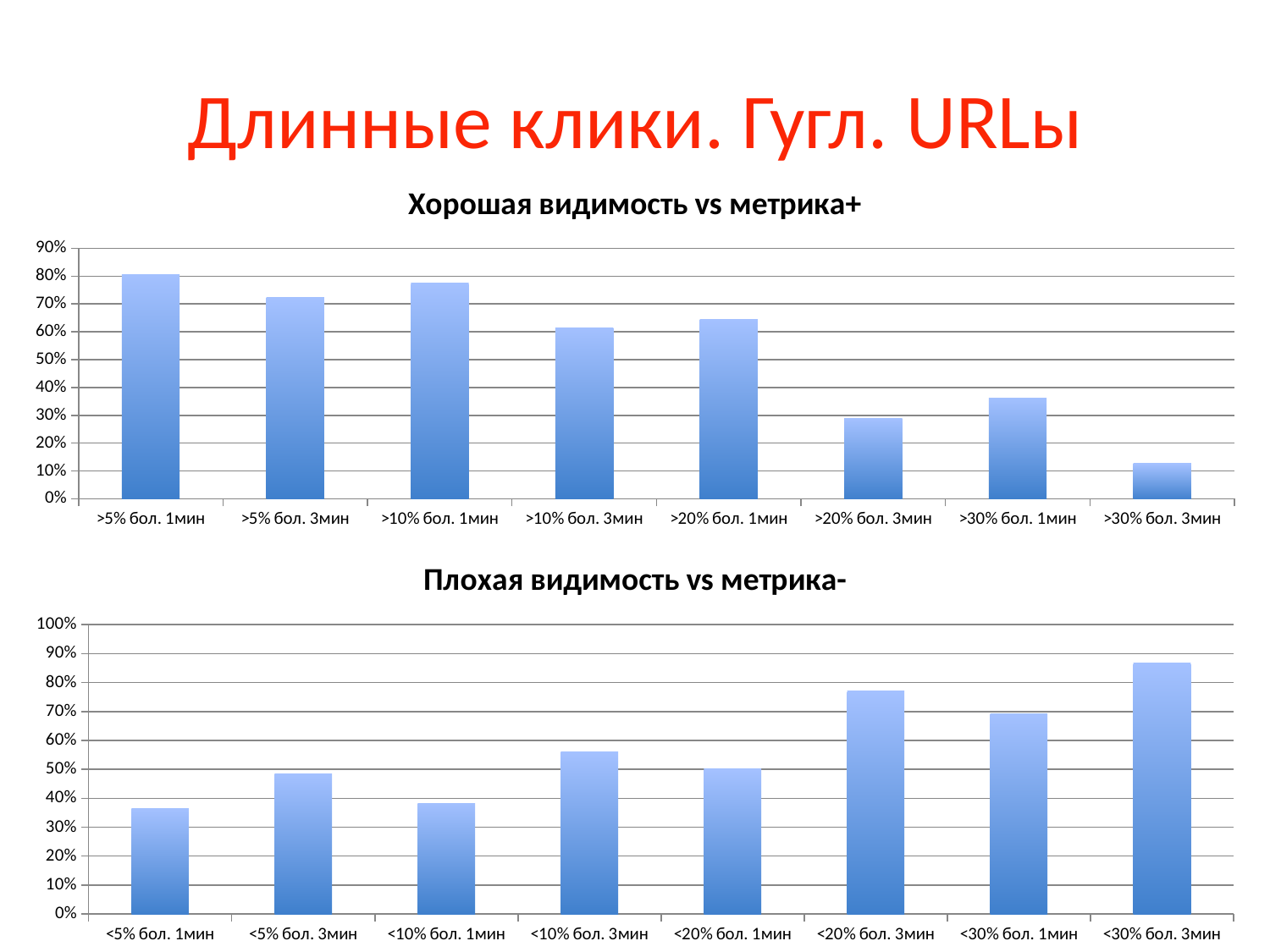
In the bottom chart 'Плохая видимость vs метрика-', which is larger: the value for '<30% бол. 1мин' or for '<5% бол. 1мин'? <30% бол. 1мин In the bottom chart 'Плохая видимость vs метрика-', which category has the highest value? <30% бол. 3мин In the top chart 'Хорошая видимость vs метрика+', how many categories are shown on the x axis? 8 In the bottom chart 'Плохая видимость vs метрика-', is the value for '<20% бол. 3мин' greater or less than 70%? greater In the top chart 'Хорошая видимость vs метрика+', which is larger: the value for '>5% бол. 3мин' or for '>20% бол. 3мин'? >5% бол. 3мин In the top chart 'Хорошая видимость vs метрика+', which category has the lowest value? >30% бол. 3мин In the top chart 'Хорошая видимость vs метрика+', is the value for '>30% бол. 3мин' greater or less than 20%? less In the top chart 'Хорошая видимость vs метрика+', is the value for '>20% бол. 1мин' greater or less than 60%? greater What kind of chart is the top chart, 'Хорошая видимость vs метрика+'? bar chart In the top chart 'Хорошая видимость vs метрика+', which category has the highest value? >5% бол. 1мин In the bottom chart 'Плохая видимость vs метрика-', do the values generally rise or fall from left to right along the x axis? rise